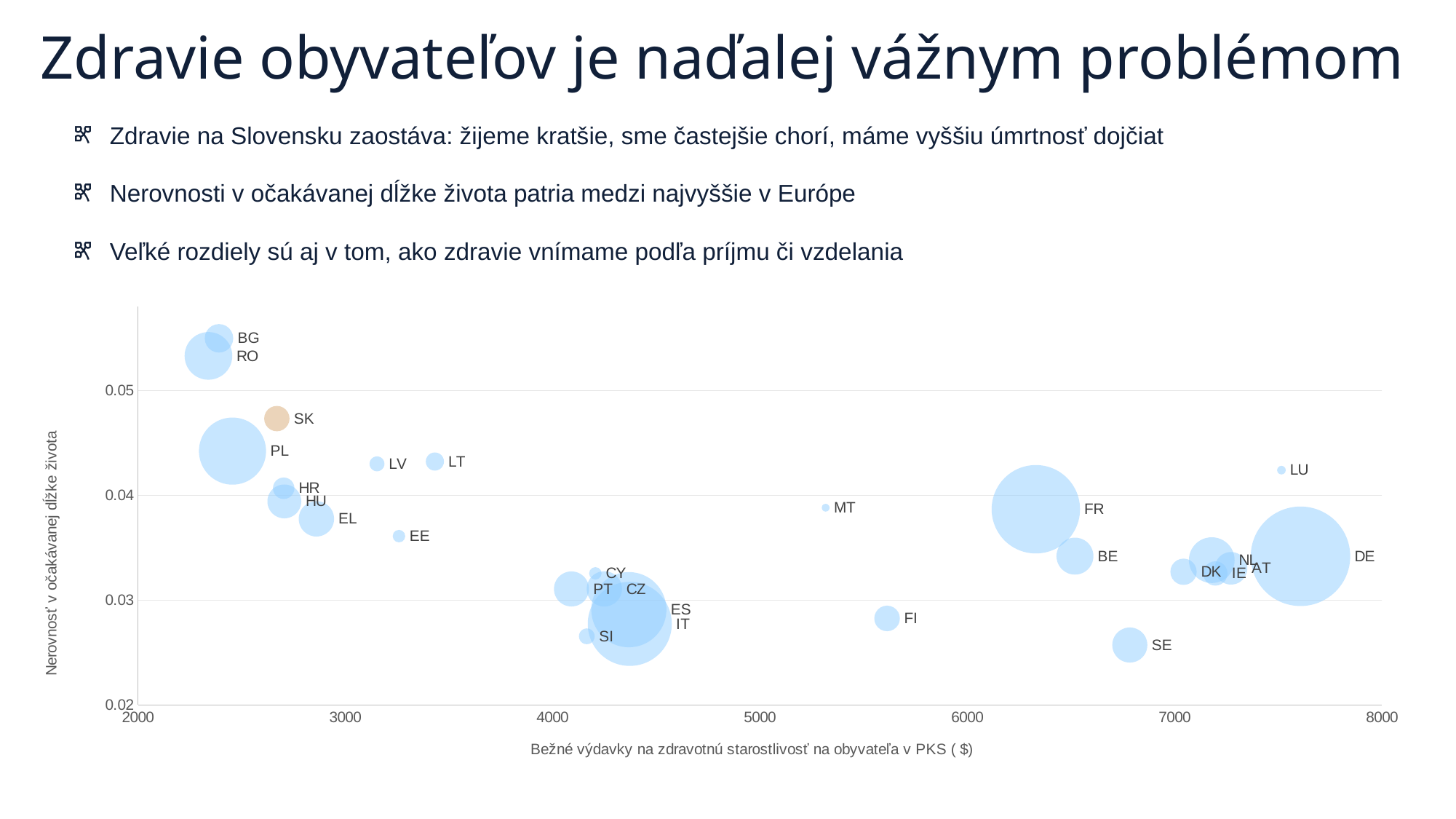
Is the vertical-axis value for BG greater or less than 0.05? greater Which country is plotted furthest to the right on the horizontal axis (highest health spending per capita)? DE Which has the higher vertical-axis value, SK or PL? SK Which country's bubble is shown in a different colour (beige) from the others? SK Is the vertical-axis value for SE greater or less than 0.03? less Is the vertical-axis value for LU greater or less than 0.04? greater What kind of chart is shown on the slide? bubble chart Which country has the highest value on the vertical axis (inequality in life expectancy)? BG Which is plotted further to the right on the horizontal axis, FR or DE? DE